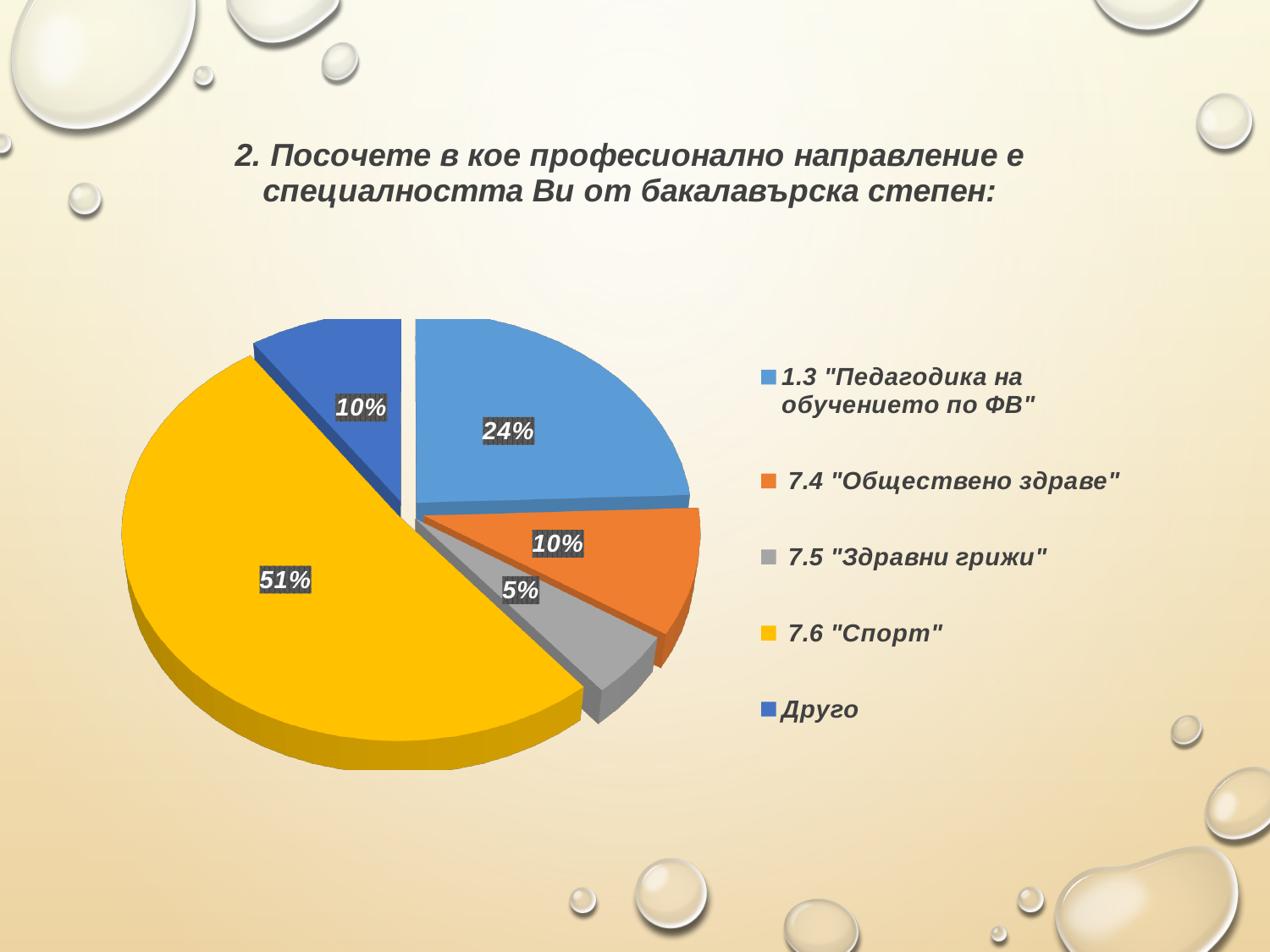
How many categories does the pie chart show? 5 What is the value shown for 1.3 "Педагогика на обучението по ФВ"? 24% What is the value shown for 7.5 "Здравни грижи"? 5% What kind of chart is shown on the slide? Pie chart What is the value shown for 7.4 "Обществено здраве"? 10% What is the difference between the shares of 7.6 "Спорт" and 1.3 "Педагогика на обучението по ФВ"? 27% Which category has the largest slice of the pie? 7.6 "Спорт" Which category has the smallest slice of the pie? 7.5 "Здравни грижи" What share of the pie does 7.6 "Спорт" have? 51% What is the value shown for Друго? 10% What colour is the slice for 7.6 "Спорт"? Yellow Which is larger, the share for 1.3 "Педагогика на обучението по ФВ" or the share for 7.4 "Обществено здраве"? 1.3 "Педагогика на обучението по ФВ"